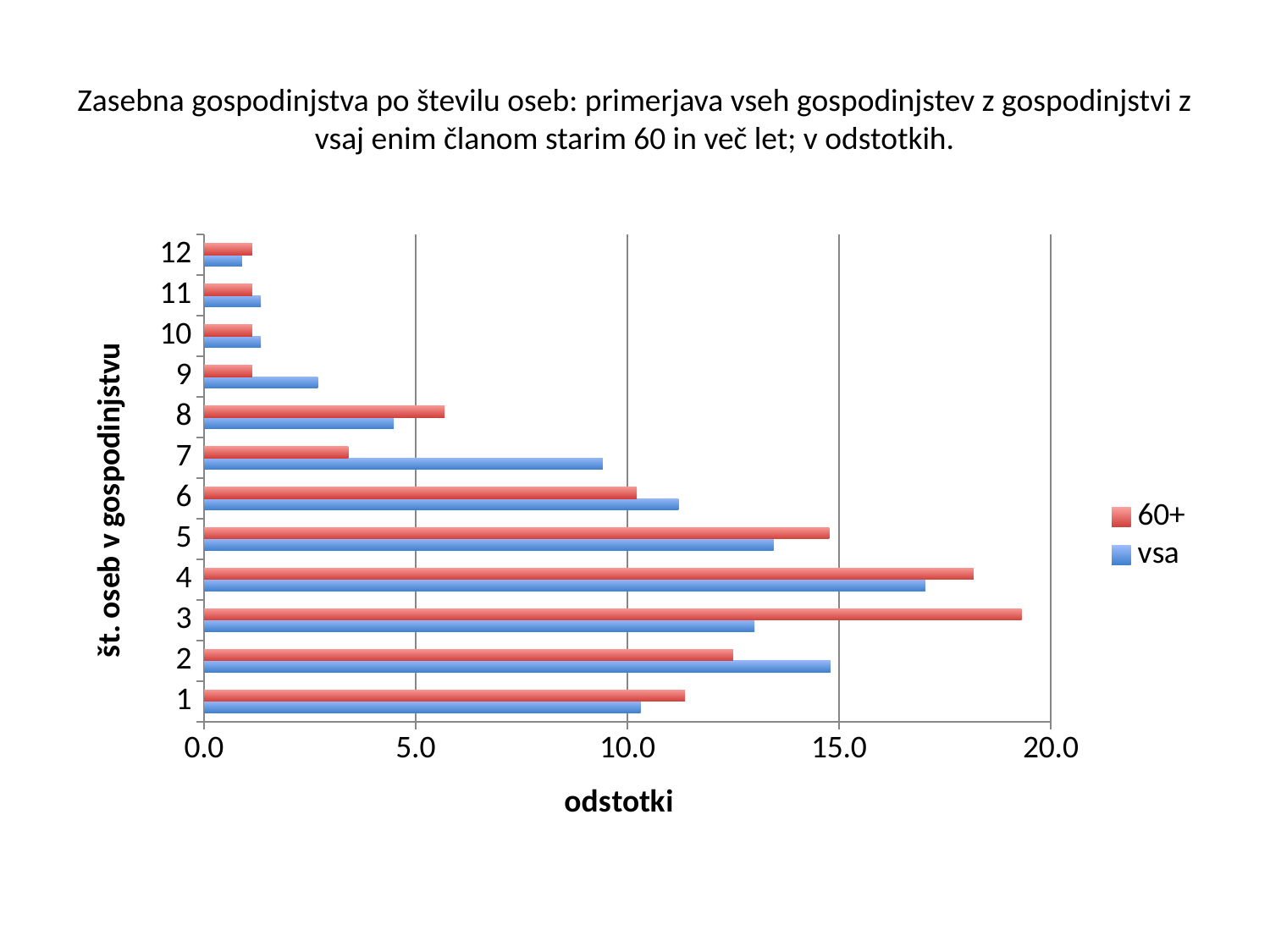
What kind of chart is shown on the slide? bar chart Is the vsa value for household size 4 greater or less than 15.0? greater How many series does the legend list? 2 What is the title of the x axis? odstotki Is the vsa value for household size 7 greater or less than 10.0? less Which household size has the highest value for the 60+ series? 3 Which household size has the highest value for the vsa series? 4 For household size 3, which series has the larger value, 60+ or vsa? 60+ Is the 60+ value for household size 3 greater or less than 15.0? greater How many household-size categories are shown on the y axis? 12 For household size 7, which series has the larger value, 60+ or vsa? vsa